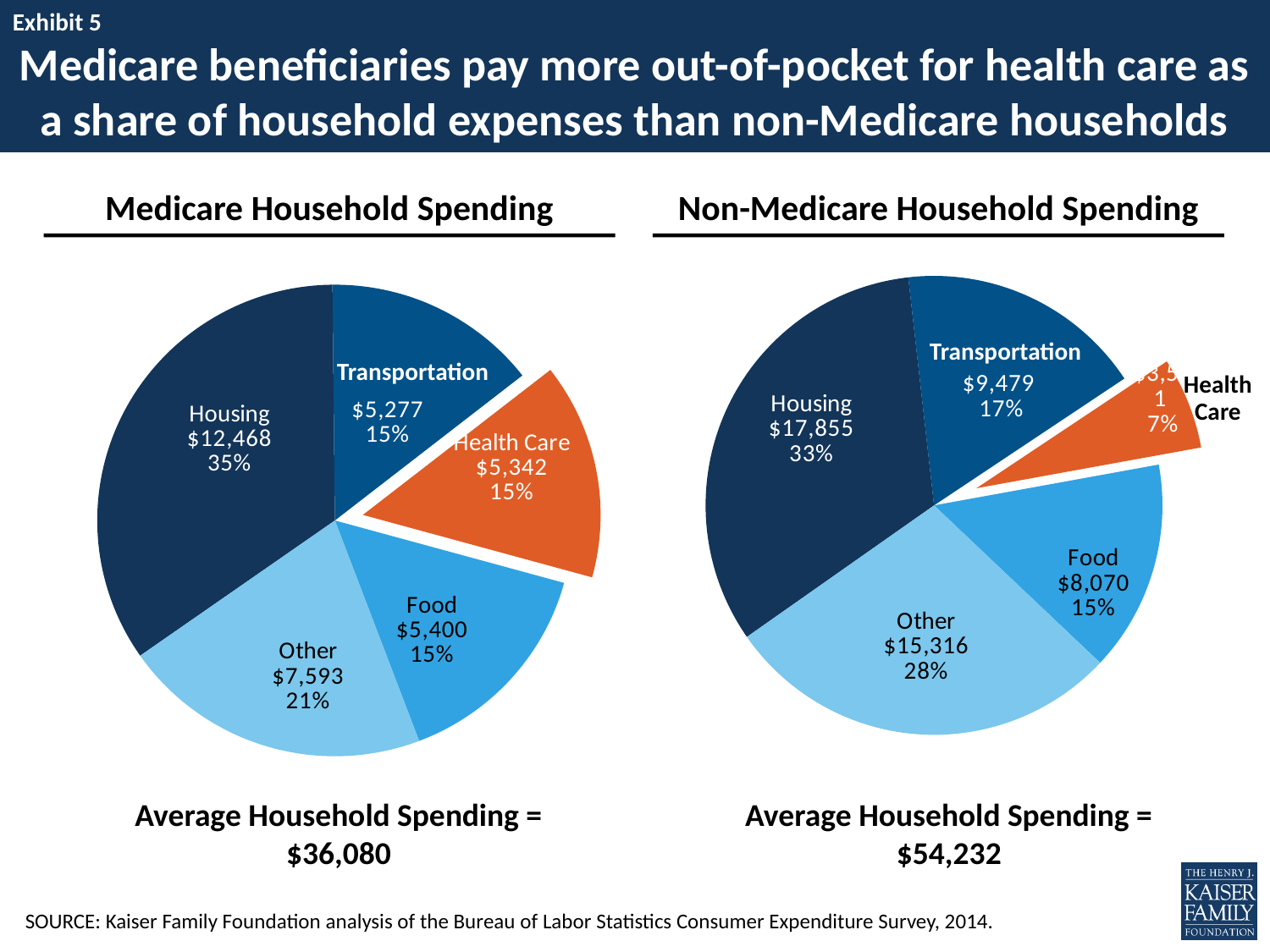
In the Medicare Household Spending chart, which is larger in dollars, Other or Transportation? Other In the Non-Medicare Household Spending chart, which category has the smallest share? Health Care In the Non-Medicare Household Spending chart, what share of spending goes to Transportation? 17% In the Medicare Household Spending chart, what share of spending goes to Health Care? 15% What kind of chart is the Non-Medicare Household Spending chart? Pie chart In the Medicare Household Spending chart, which category has the largest share? Housing In the Non-Medicare Household Spending chart, what is the difference in dollars between Housing and Food? $9,785 In the Medicare Household Spending chart, what is the dollar value for Housing? $12,468 In the Non-Medicare Household Spending chart, what share of spending goes to Health Care? 7% What is the average household spending shown below the Non-Medicare Household Spending chart? $54,232 How many categories are shown in the Medicare Household Spending chart? 5 In the Non-Medicare Household Spending chart, what is the dollar value for Other? $15,316